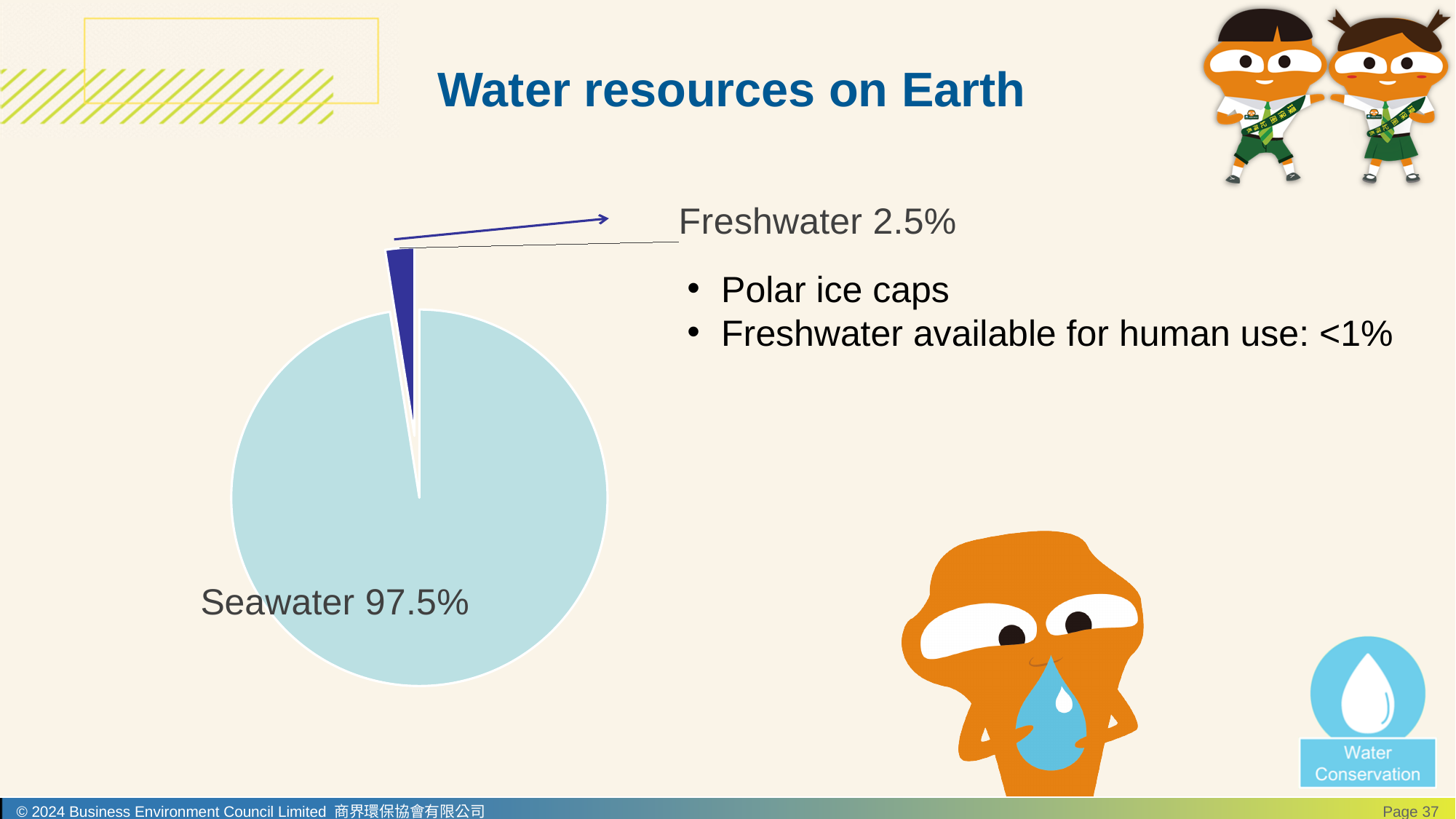
Which is larger, the seawater slice or the freshwater slice? Seawater Is the seawater share greater or less than 90%? greater What is the title of the slide containing the pie chart? Water resources on Earth What is the difference in percentage points between the seawater and freshwater slices? 95 Which slice of the pie chart is the largest? Seawater What kind of chart is shown on the slide? pie chart What share of water resources on Earth is seawater according to the pie chart? 97.5% Which slice of the pie chart is the smallest? Freshwater What colour is the freshwater slice of the pie chart? dark blue How many slices does the pie chart have? 2 What share of water resources on Earth is freshwater according to the pie chart? 2.5%